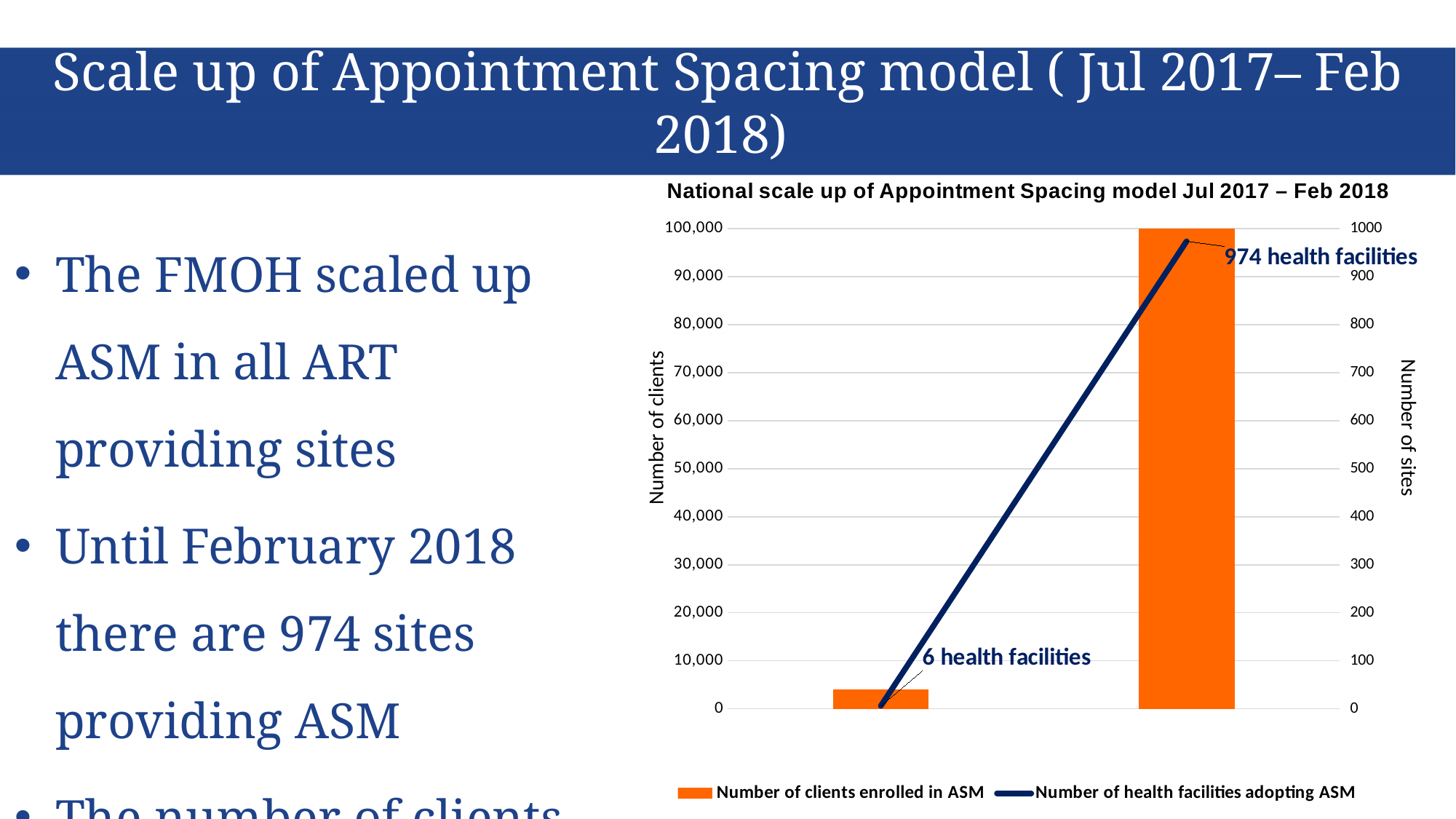
Which series is drawn as a line rather than bars? Number of health facilities adopting ASM What value does the data label on the right-hand point of the line show for the number of health facilities adopting ASM? 974 health facilities How many series does the chart legend list? 2 By how many health facilities did the number of health facilities adopting ASM increase from the first point to the second point? 968 What value does the data label on the left-hand point of the line show for the number of health facilities adopting ASM? 6 health facilities What is the title of the chart? National scale up of Appointment Spacing model Jul 2017 – Feb 2018 Is the number of clients enrolled in ASM for the right-hand bar greater or less than 90,000? greater What is the title of the left vertical axis? Number of clients Is the number of clients enrolled in ASM for the left-hand bar greater or less than 10,000? less How many bars are plotted for the number of clients enrolled in ASM? 2 Which bar is taller, the left-hand bar or the right-hand bar for number of clients enrolled in ASM? the right-hand bar Does the number of health facilities adopting ASM rise or fall from left to right along the chart? rise